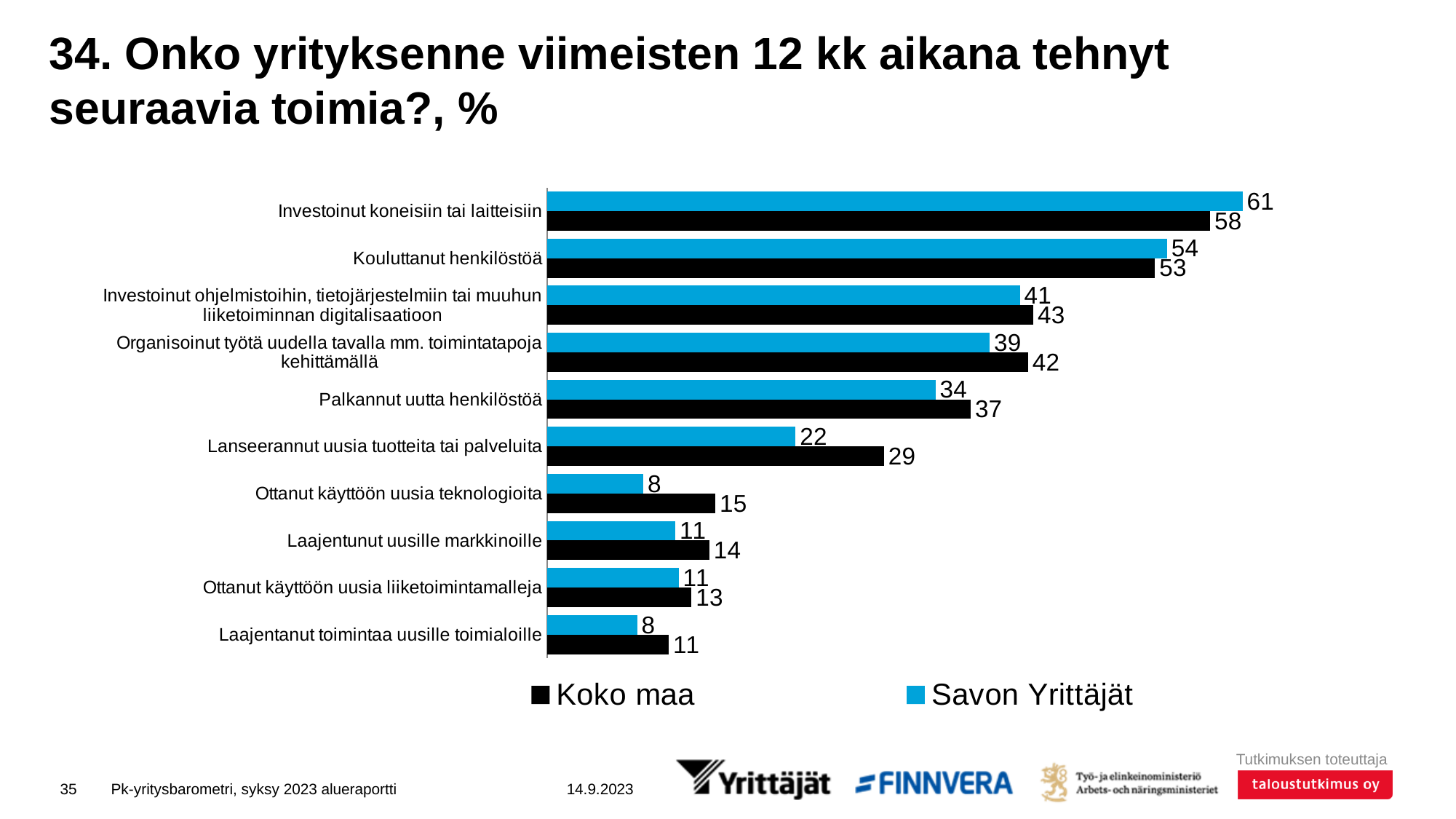
What kind of chart is shown on the slide? Bar chart Which category has the lowest value for Koko maa? Laajentanut toimintaa uusille toimialoille What is the difference between the Savon Yrittäjät and Koko maa values for "Investoinut koneisiin tai laitteisiin"? 3 How many series does the legend list? 2 Which category has the highest value for Savon Yrittäjät? Investoinut koneisiin tai laitteisiin What is the value for Koko maa for "Ottanut käyttöön uusia teknologioita"? 15 For "Palkannut uutta henkilöstöä", which series has the larger value, Koko maa or Savon Yrittäjät? Koko maa How many categories are shown in the chart? 10 What is the difference between the Koko maa and Savon Yrittäjät values for "Lanseerannut uusia tuotteita tai palveluita"? 7 For "Kouluttanut henkilöstöä", which series has the larger value, Koko maa or Savon Yrittäjät? Savon Yrittäjät What is the value for Koko maa for "Lanseerannut uusia tuotteita tai palveluita"? 29 What is the value for Savon Yrittäjät for "Investoinut koneisiin tai laitteisiin"? 61